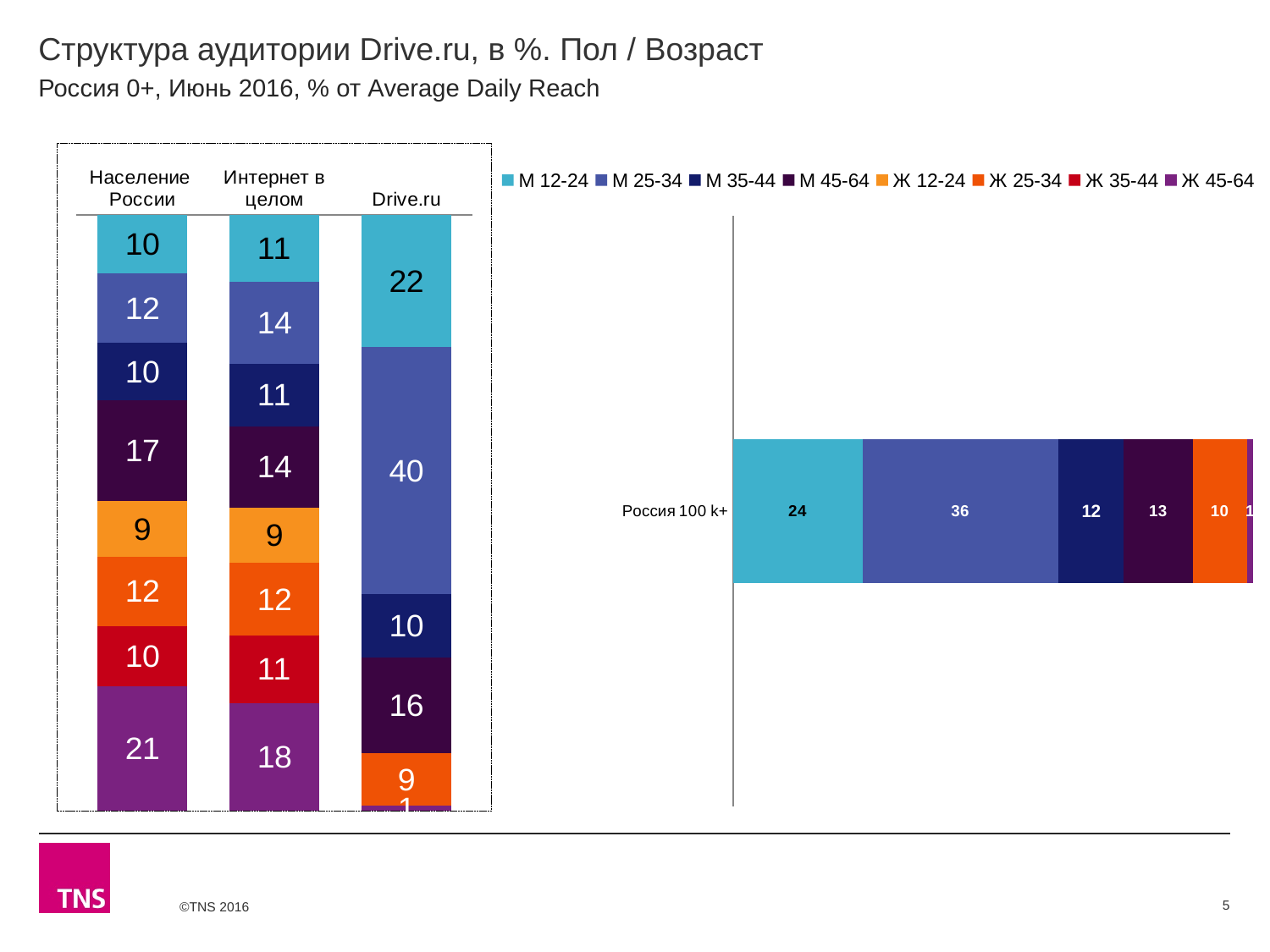
On the left chart, what is the value of the largest segment in the Drive.ru column? 40 On the right chart (Россия 100 k+), what kind of chart is it? bar chart On the right chart, what is the value for М 25-34 for Россия 100 k+? 36 On the left chart, what is the value of the bottom segment of the Население России column? 21 On the left chart, what is the value of the top segment of the Drive.ru column? 22 On the left chart, what is the value of the bottom segment of the Интернет в целом column? 18 On the right chart, what is the difference between the М 25-34 and М 12-24 values for Россия 100 k+? 12 On the right chart (Россия 100 k+), how many series does the legend list? 8 On the right chart, what is the value for М 12-24 for Россия 100 k+? 24 On the left chart, how many stacked columns are shown? 3 On the right chart, which series has the largest segment for Россия 100 k+? М 25-34 On the right chart, what is the value for М 45-64 for Россия 100 k+? 13